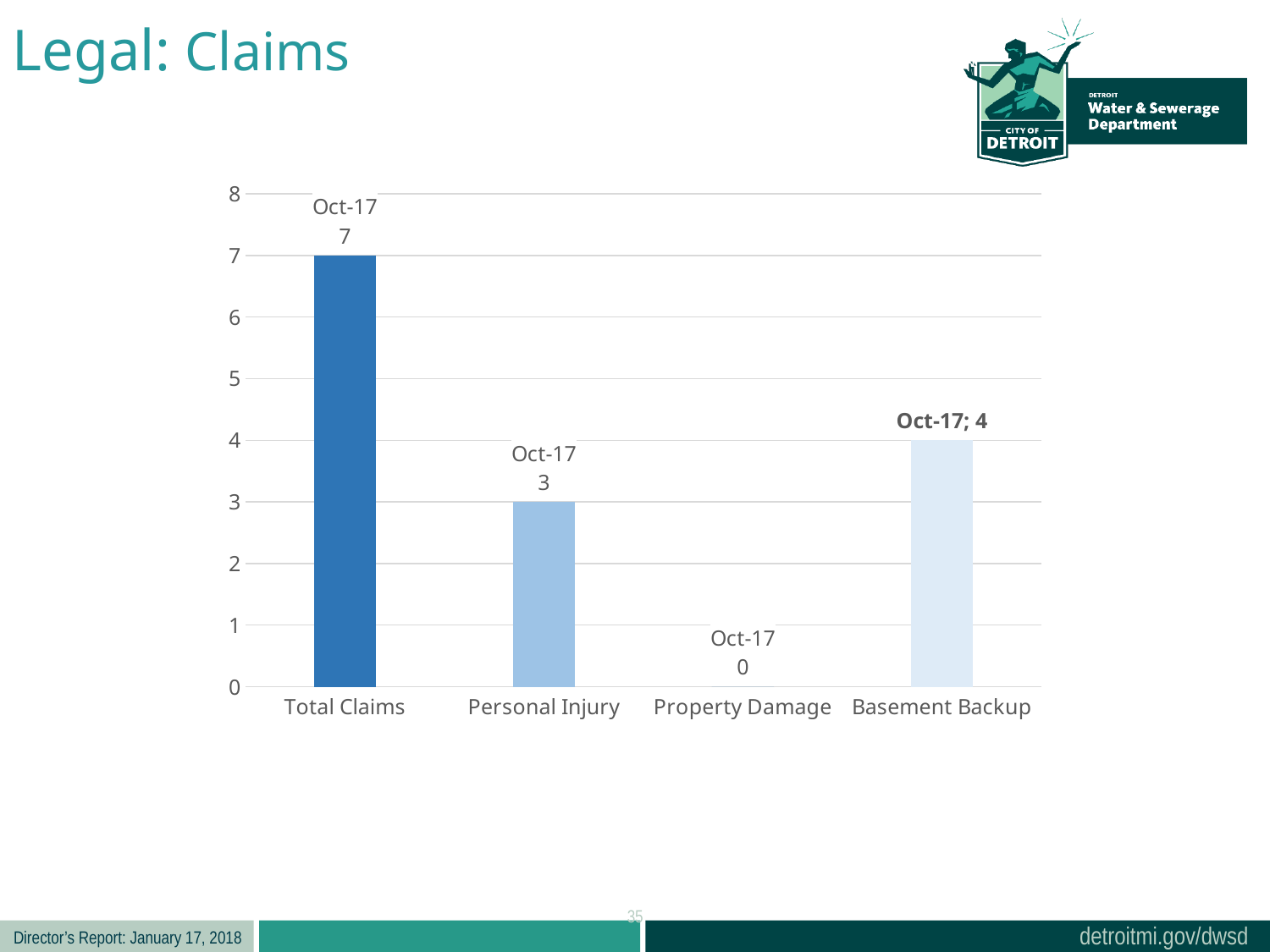
What is the value for Total Claims? 7 How many categories are shown on the x axis? 4 Is the value for Total Claims greater or less than 5? greater Which category has the lowest value? Property Damage Which category has the highest value? Total Claims What is the value for Property Damage? 0 Which is larger, Personal Injury or Basement Backup? Basement Backup What is the value for Personal Injury? 3 What kind of chart is shown on the slide? bar chart What is the difference between Total Claims and Basement Backup? 3 Which month do the data labels on the chart refer to? Oct-17 What is the value for Basement Backup? 4